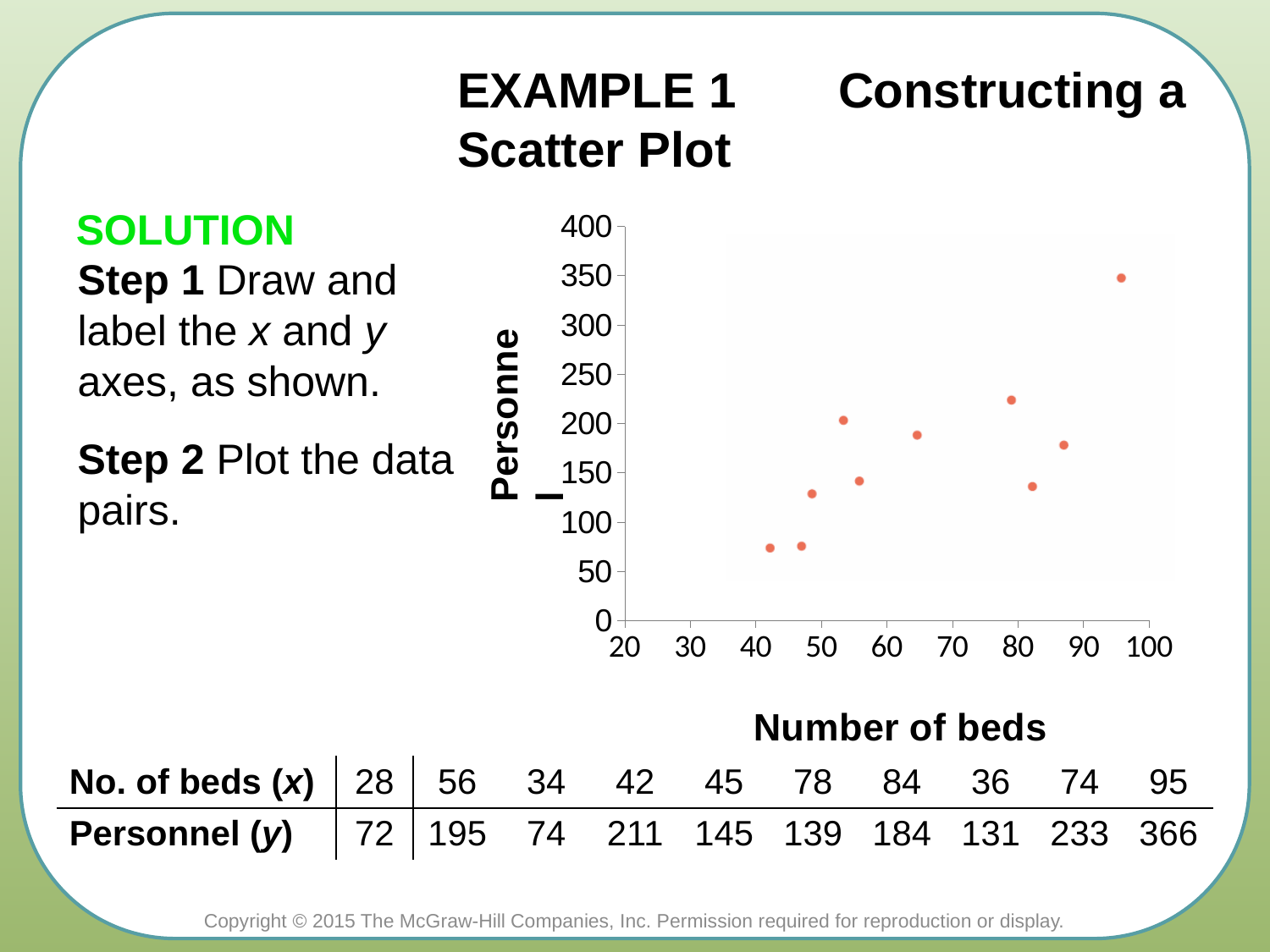
According to the data table, what is the personnel value for 78 beds? 139 Do the personnel values generally rise or fall as the number of beds increases? Rise How many data points are plotted in the scatter plot? 10 According to the data table, which number of beds has the lowest personnel value? 28 What is the label of the x axis of the scatter plot? Number of beds According to the data table, which number of beds has the highest personnel value? 95 Is the highest plotted personnel value greater or less than 300? greater Is the lowest plotted personnel value greater or less than 100? less According to the data table, what is the difference between the highest personnel value (366) and the lowest (72)? 294 What is the label of the y axis of the scatter plot? Personnel What kind of chart is shown on the slide? Scatter plot According to the data table, what is the personnel value for 56 beds? 195